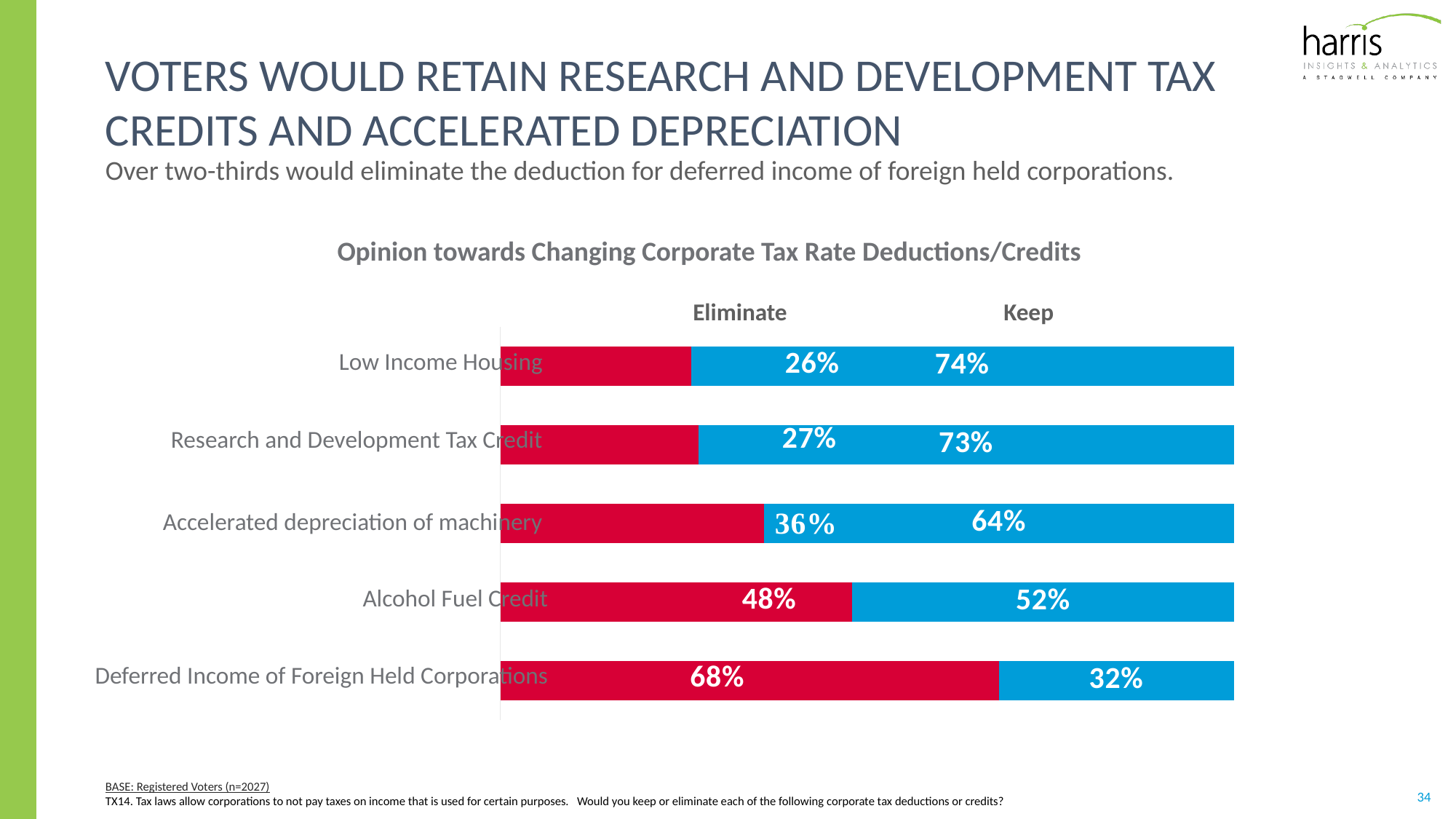
What percentage of voters would eliminate the deduction for Deferred Income of Foreign Held Corporations? 68% How many series does the chart show? 2 Which category has the highest Eliminate percentage? Deferred Income of Foreign Held Corporations What type of chart is shown on the slide? Stacked bar chart What is the title of the chart? Opinion towards Changing Corporate Tax Rate Deductions/Credits What is the difference between the Keep and Eliminate percentages for the Alcohol Fuel Credit? 4% What percentage of voters would keep the Low Income Housing deduction? 74% Which category has the lowest Keep percentage? Deferred Income of Foreign Held Corporations What is the Keep value for the Research and Development Tax Credit? 73% What is the Eliminate value for Accelerated depreciation of machinery? 36% Which is larger for Accelerated depreciation of machinery: the Eliminate share or the Keep share? Keep How many deductions/credits are shown in the chart? 5